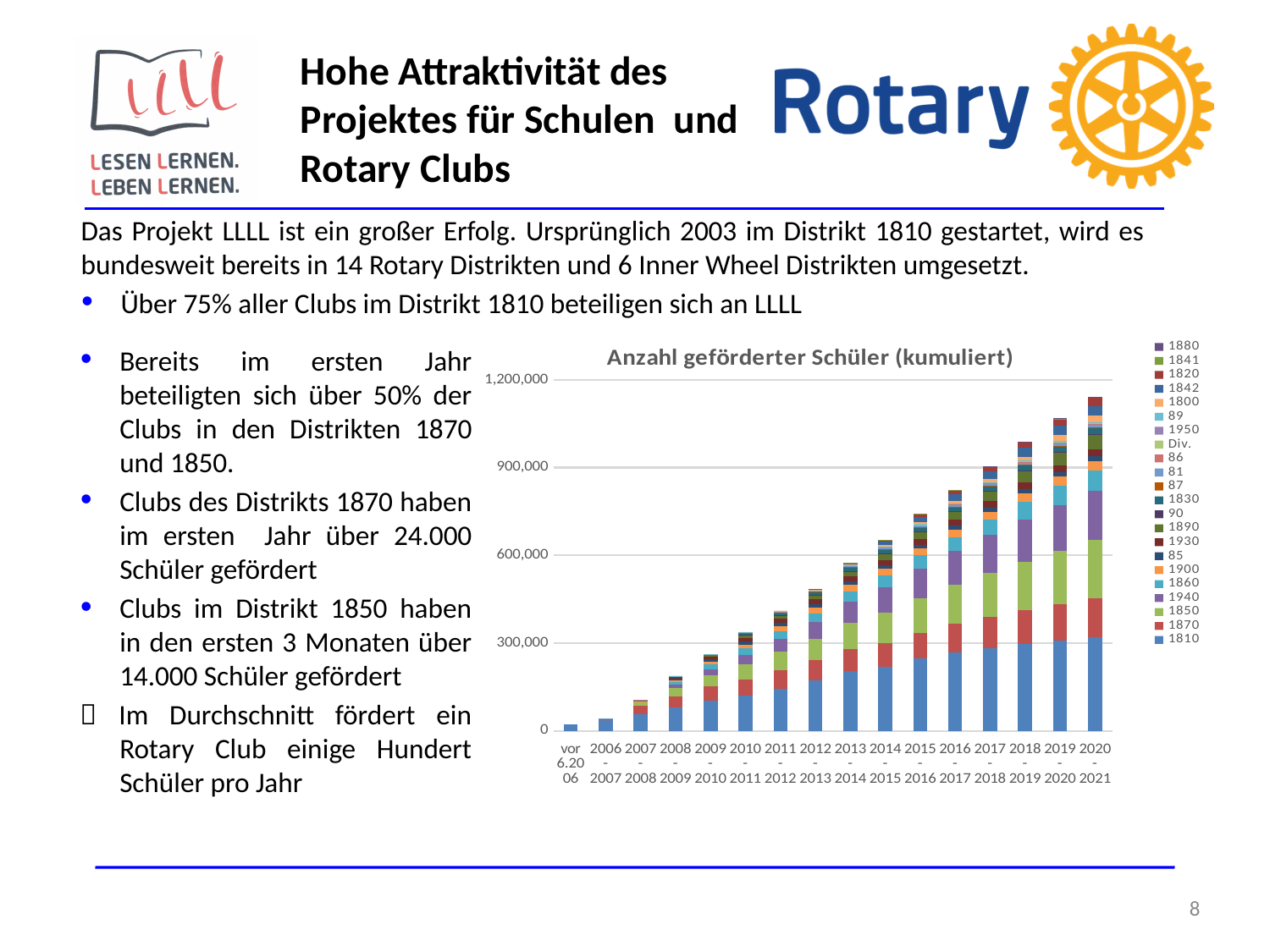
Which period has the tallest stacked bar in the chart? 2020-2021 How many series does the chart legend list? 22 Is the total for 2014-2015 greater or less than 600,000? greater What is the title of the chart? Anzahl geförderter Schüler (kumuliert) Is the total for 2009-2010 greater or less than 300,000? less Is the total for 2016-2017 greater or less than 900,000? less Which series forms the bottom (blue) segment of each stacked bar? 1810 Do the stacked bar totals rise or fall from left to right along the x axis? Rise How many bars (time periods) are shown on the x axis of the chart? 16 What kind of chart is shown on the slide? Stacked bar chart Which period has the shortest stacked bar in the chart? vor 6.2006